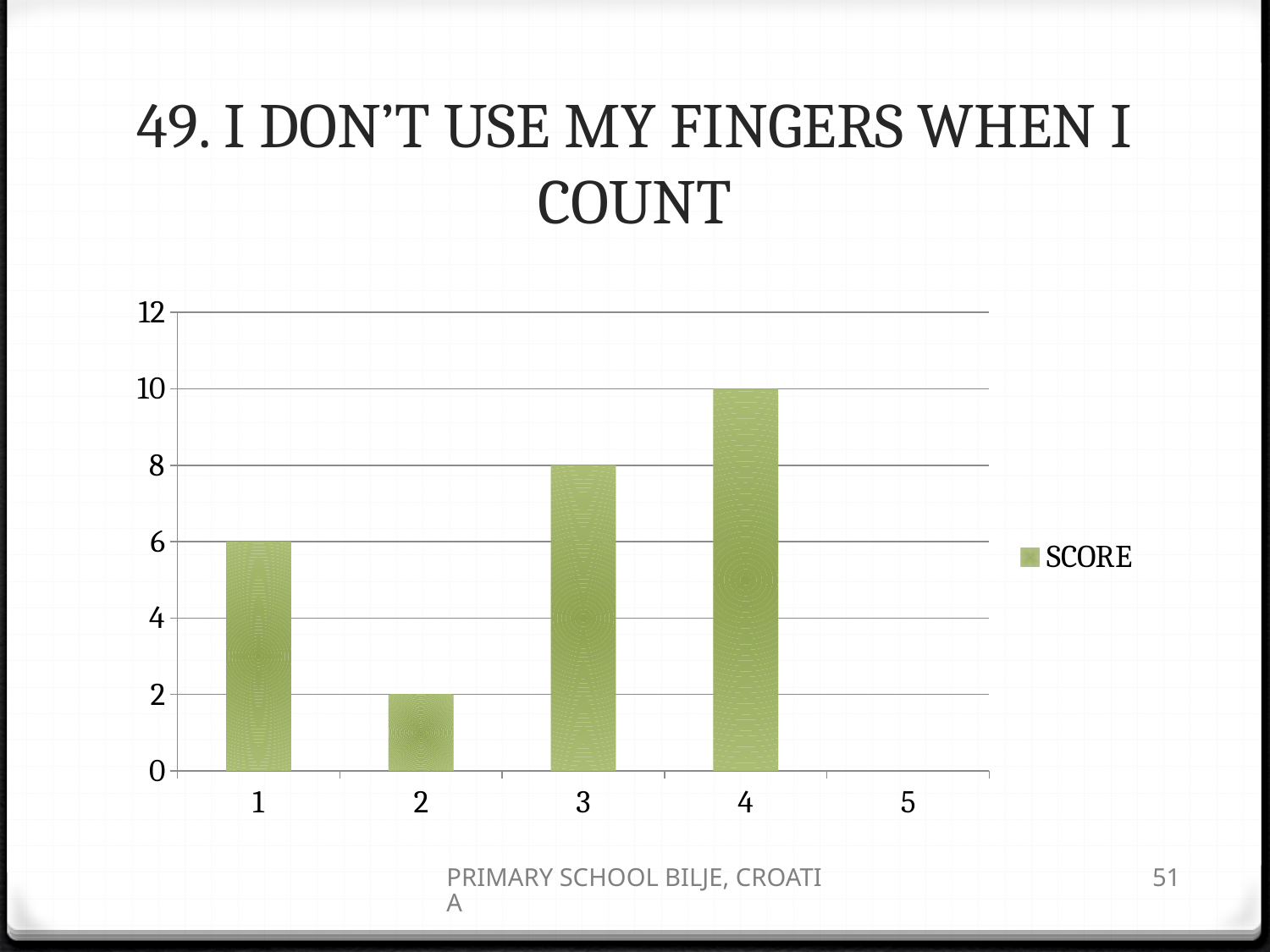
Which is larger, the value for category 1 or the value for category 3? category 3 Which category has the highest value? 4 What is the difference between the values for category 4 and category 3? 2 What is the value for category 2? 2 What is the value for category 4? 10 What is the value for category 1? 6 Is the value for category 3 greater or less than 6? greater How many categories are shown on the x axis? 5 What is the value for category 3? 8 What type of chart is shown on the slide? bar chart How many series does the legend list? 1 Among categories 1 to 4, which has the lowest value? 2